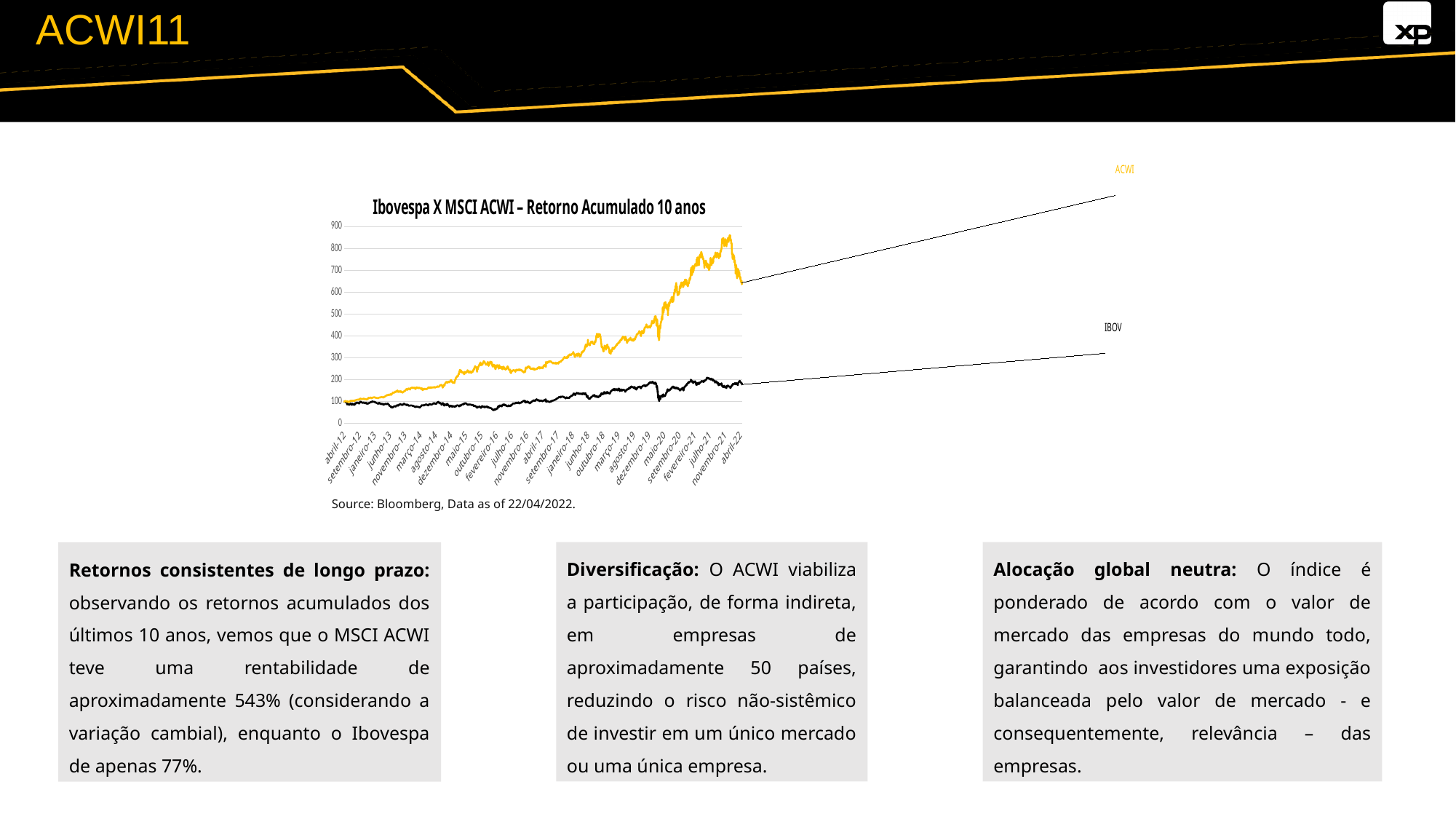
What kind of chart is shown on the slide? line chart Is the value of ACWI at abril-22 greater or less than 500? greater Is the value of IBOV at abril-22 greater or less than 300? less Which series is drawn in yellow on the chart? ACWI Is the highest value reached by IBOV greater or less than 300? less Which series reaches the highest value on the chart? ACWI At what value do both series start at abril-12? 100 What is the title of the chart? Ibovespa X MSCI ACWI – Retorno Acumulado 10 anos How many series does the chart show? 2 Does the ACWI series rise or fall overall from abril-12 to abril-22? rise At abril-22, which series has the higher value, ACWI or IBOV? ACWI